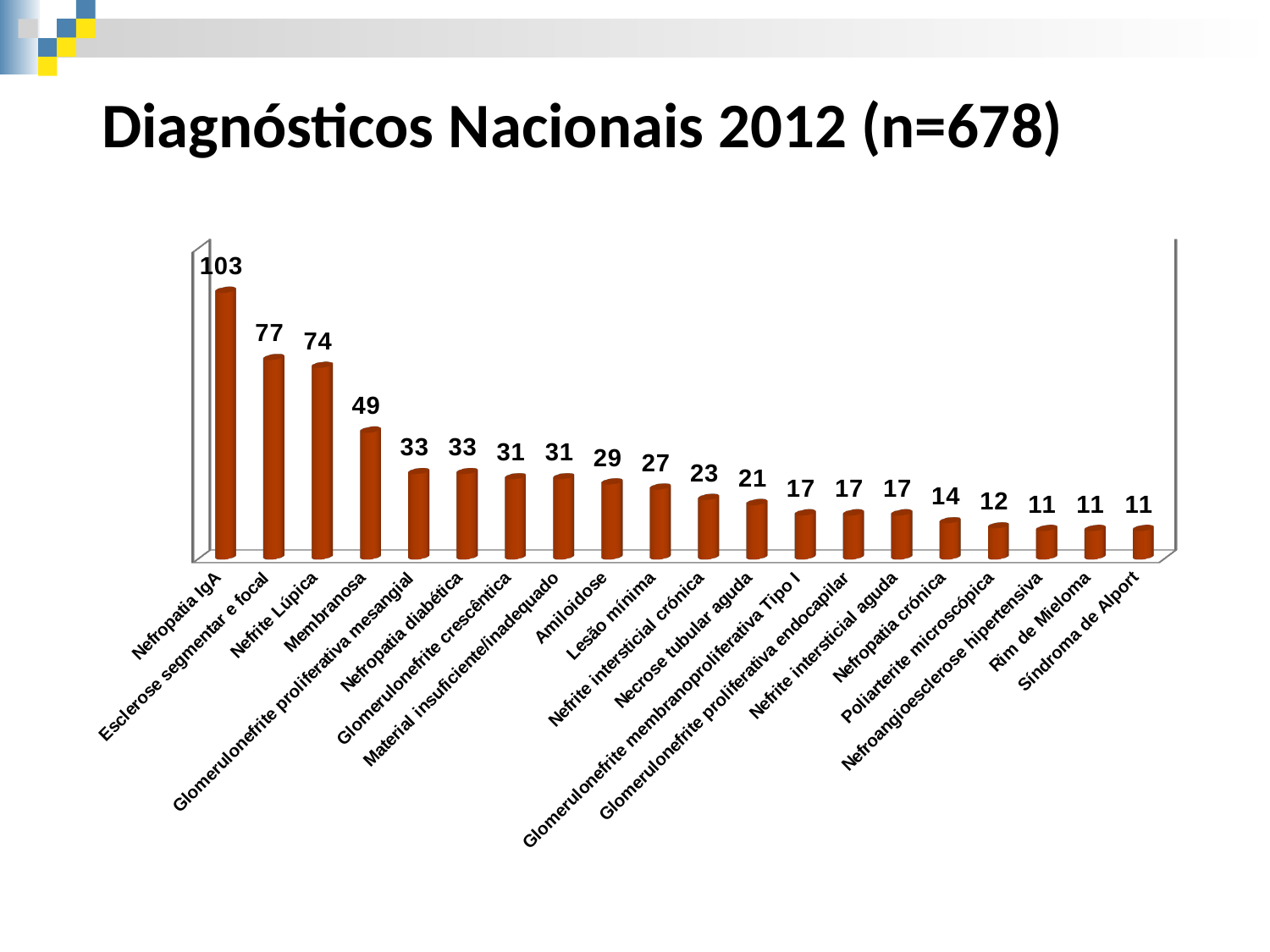
What is the value for Necrose tubular aguda? 21 What is the value for Membranosa? 49 Which is larger, the value for Lesão mínima or the value for Nefrite intersticial crónica? Lesão mínima What is the difference between the values for Nefrite Lúpica and Membranosa? 25 What is the value for Poliarterite microscópica? 12 What is the value for Amiloidose? 29 How many categories are shown in the chart? 20 What kind of chart is shown on the slide? Bar chart Which category has the highest value? Nefropatia IgA What is the value for Nefropatia IgA? 103 What is the difference between the values for Nefropatia IgA and Esclerose segmentar e focal? 26 Do the values rise or fall from left to right along the x axis? Fall